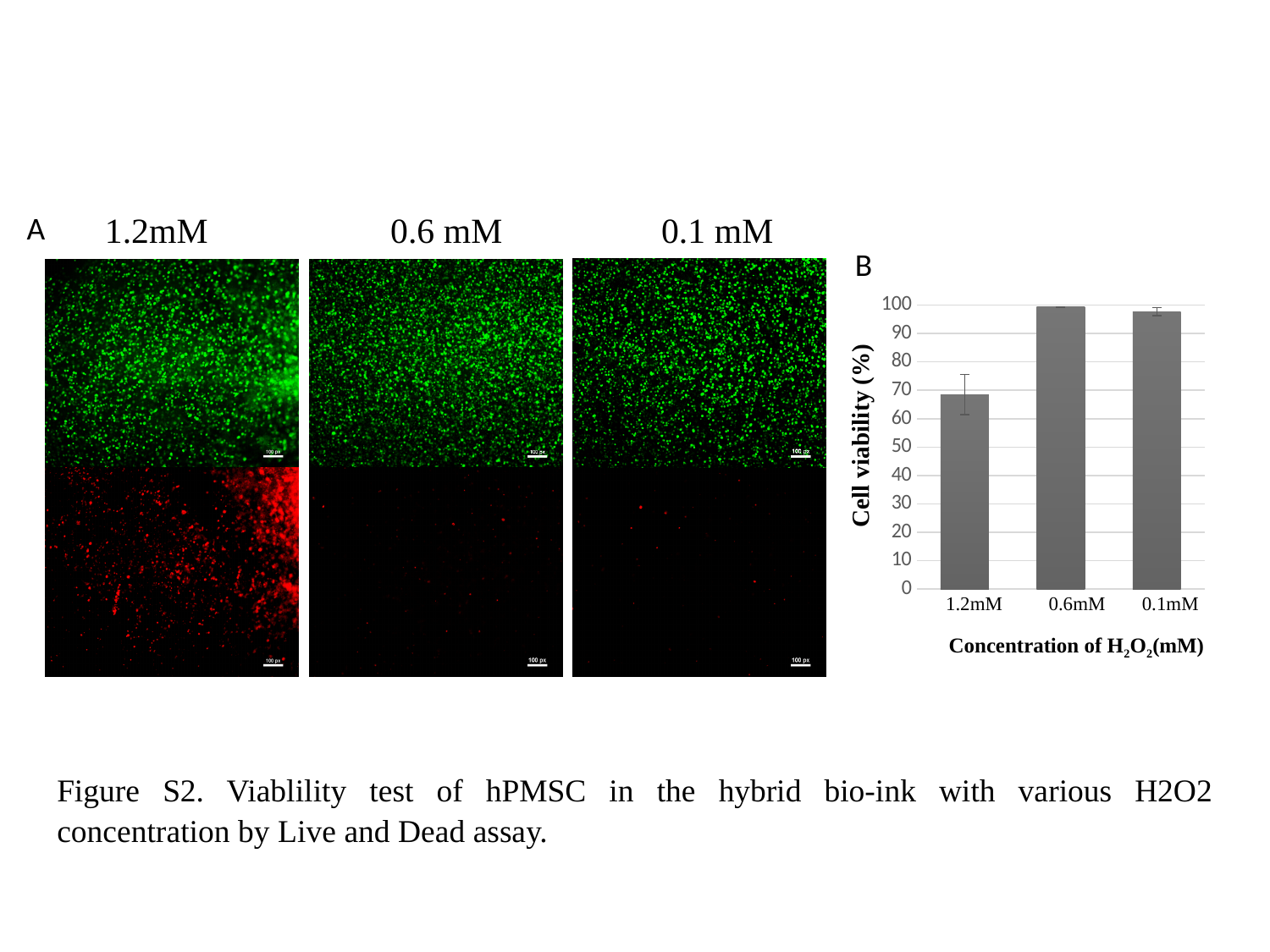
In the bar chart in panel B, is the cell viability for 0.1mM greater or less than 90? greater In the bar chart in panel B, is the cell viability for 1.2mM greater or less than 80? less In the bar chart in panel B, is the cell viability for 1.2mM greater or less than 50? greater What is the y-axis label of the bar chart in panel B? Cell viability (%) In the bar chart in panel B, which has higher cell viability, 1.2mM or 0.1mM? 0.1mM What kind of chart is shown in panel B? bar chart How many concentration categories are plotted in the bar chart in panel B? 3 In the bar chart in panel B, which concentration has the lowest cell viability? 1.2mM In the bar chart in panel B, which has higher cell viability, 1.2mM or 0.6mM? 0.6mM What is the x-axis label of the bar chart in panel B? Concentration of H2O2(mM)